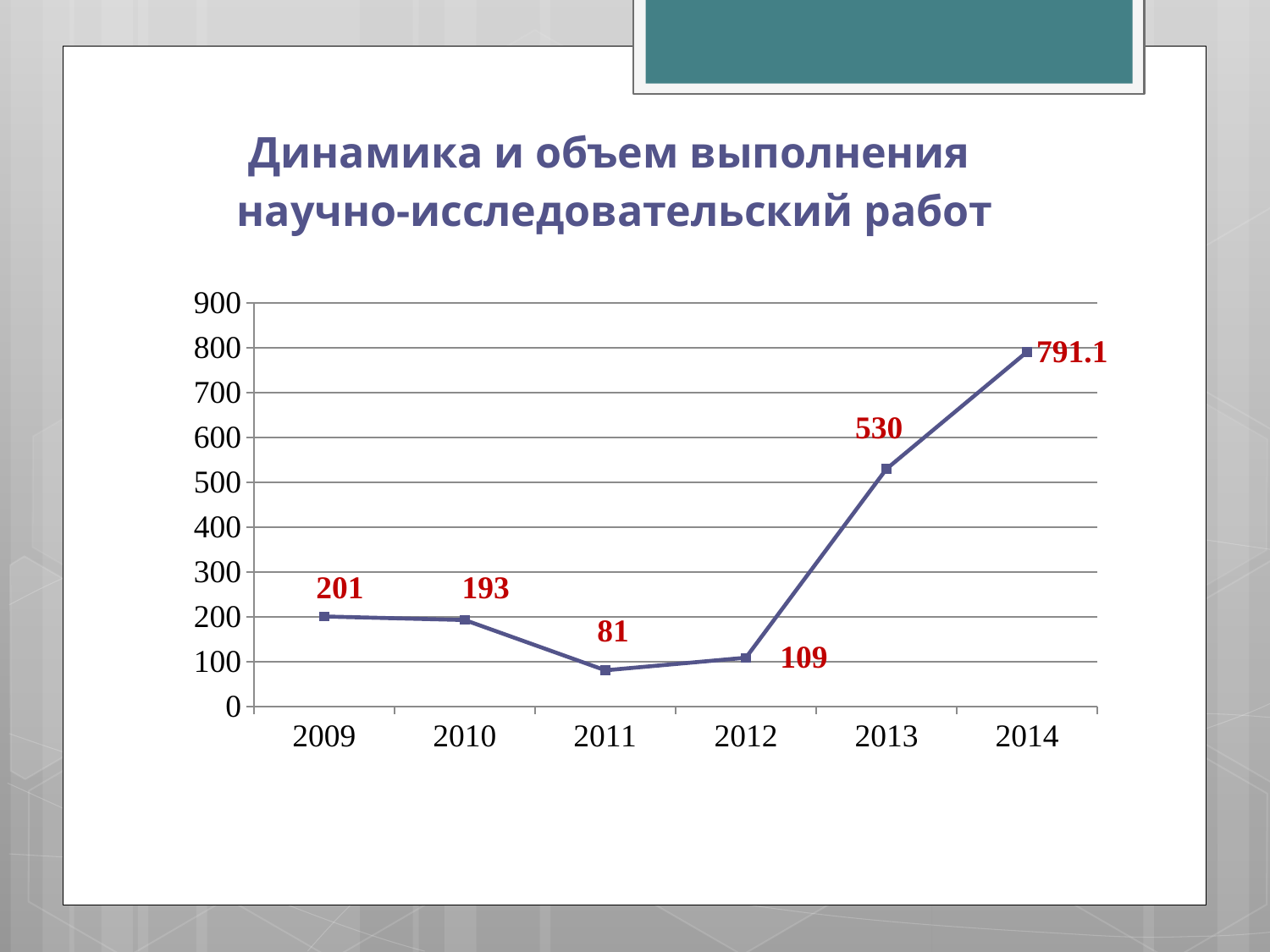
How many years are plotted on the chart? 6 What is the difference between the values for 2009 and 2010? 8 Is the value for 2013 greater or less than 500? greater Do the values rise or fall from 2012 to 2014? rise What is the difference between the values for 2013 and 2012? 421 What is the value for 2011? 81 What is the value for 2014? 791.1 Which is larger, the value for 2012 or the value for 2011? 2012 Which year has the highest value? 2014 What is the value for 2009? 201 Which year has the lowest value? 2011 What kind of chart is shown on the slide? line chart